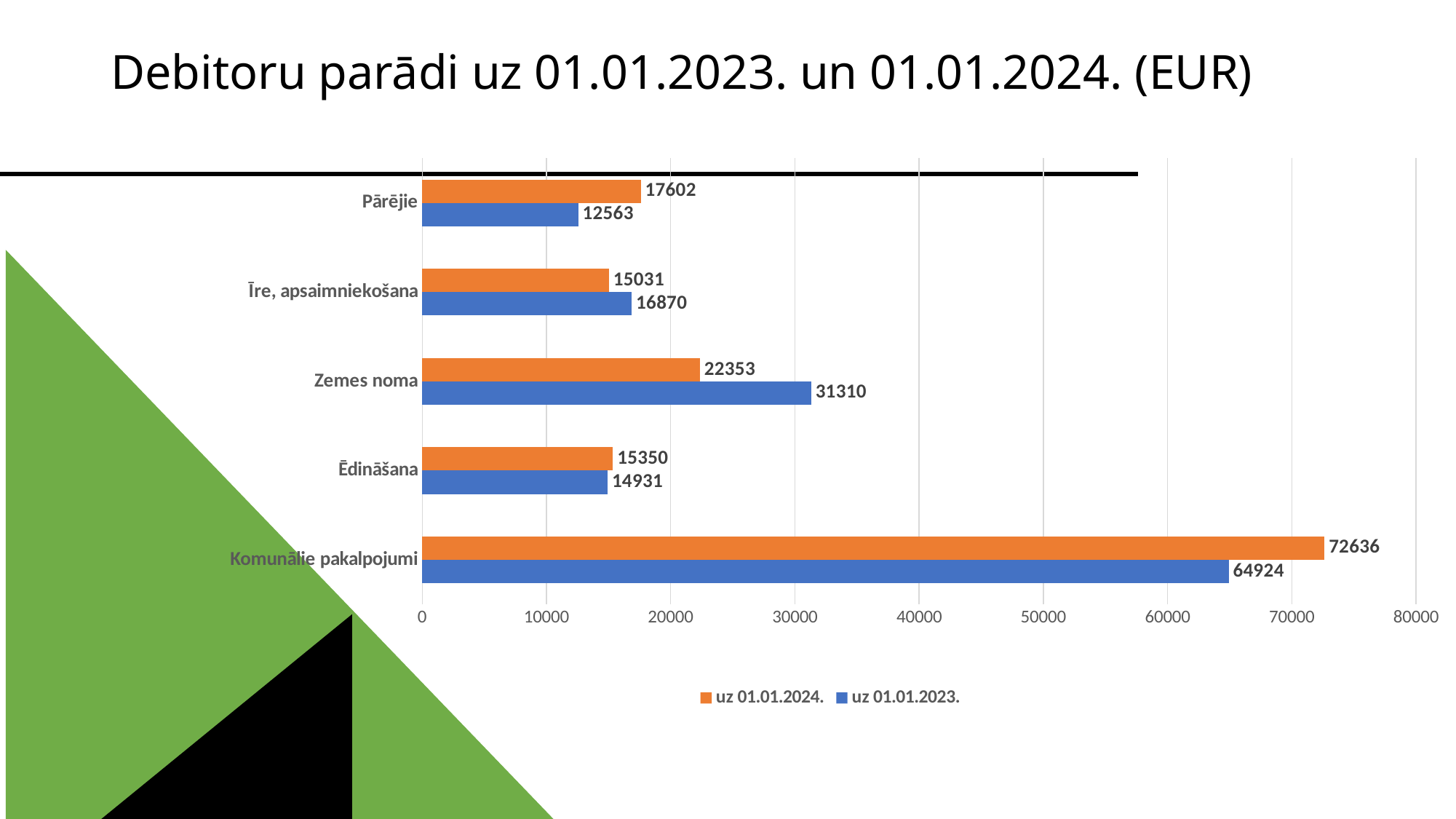
What is the value for Pārējie in the uz 01.01.2023. series? 12563 Which category has the lowest value in the uz 01.01.2023. series? Pārējie For Īre, apsaimniekošana, which series has the larger value: uz 01.01.2024. or uz 01.01.2023.? uz 01.01.2023. What kind of chart is shown on the slide? bar chart Which category has the highest value in the uz 01.01.2024. series? Komunālie pakalpojumi What is the value for Zemes noma in the uz 01.01.2023. series? 31310 Is the uz 01.01.2023. value for Komunālie pakalpojumi greater or less than 60000? greater What is the difference between the uz 01.01.2023. and uz 01.01.2024. values for Zemes noma? 8957 How many series does the legend list? 2 What is the difference between the uz 01.01.2024. and uz 01.01.2023. values for Komunālie pakalpojumi? 7712 How many categories are shown on the chart? 5 What is the value for Komunālie pakalpojumi in the uz 01.01.2024. series? 72636